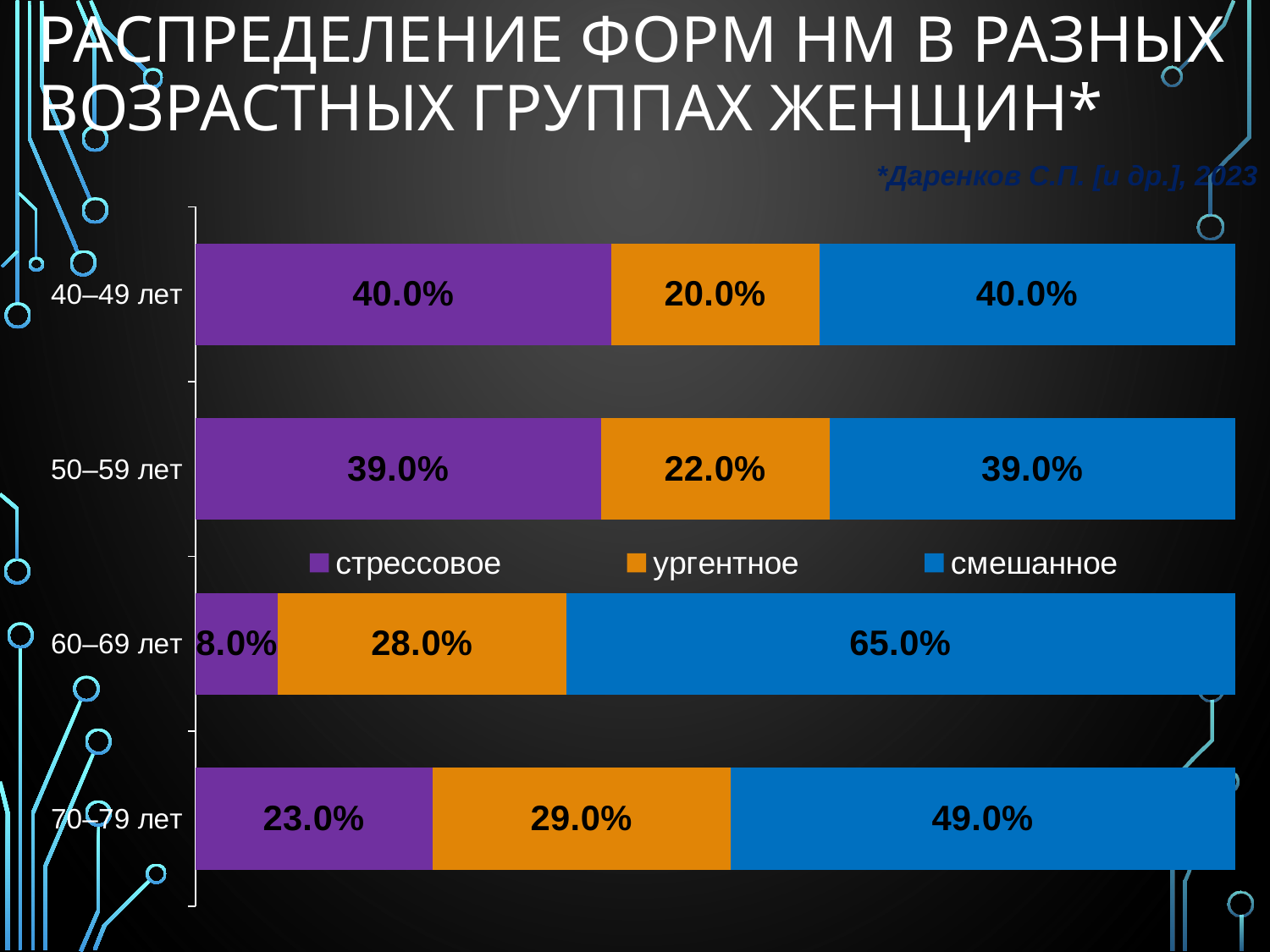
What is the value for смешанное in the 60–69 лет group? 65.0% Which age group has the lowest value for стрессовое? 60–69 лет How many age groups are shown on the chart? 4 Which is larger: ургентное for 70–79 лет or ургентное for 40–49 лет? 70–79 лет Which colour represents the ургентное series in the legend? Orange What is the total of the stacked bar for 40–49 лет? 100.0% Which age group has the highest value for смешанное? 60–69 лет What is the difference between the смешанное values for 60–69 лет and 70–79 лет? 16.0% How many series does the legend list? 3 What kind of chart is shown on the slide? Stacked bar chart What is the value for стрессовое in the 70–79 лет group? 23.0% What is the value for ургентное in the 50–59 лет group? 22.0%